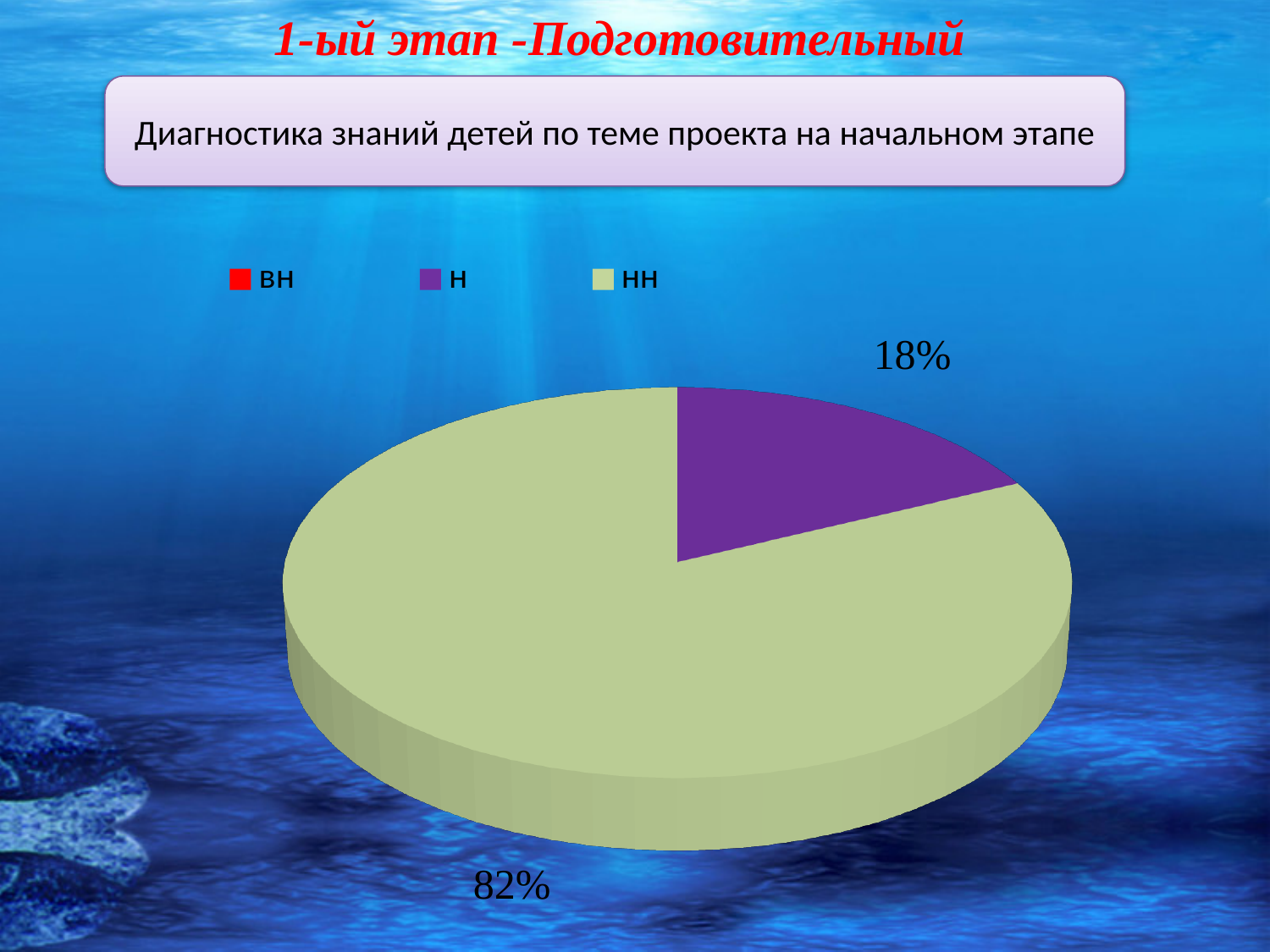
Which category has the largest slice of the pie? НН What kind of chart is shown on the slide? pie chart Which of the two visible slices is larger, Н or НН? НН What colour is the НН slice in the pie chart? light green What share of the pie does the НН slice take? 82% Which legend entry is shown in purple? Н What is the difference in percentage points between the НН slice and the Н slice? 64 What is the total of the two labelled slices, Н and НН? 100% Is the value for Н greater or less than 50%? less How many entries does the legend list? 3 What share of the pie does the Н slice take? 18% Is the value for НН greater or less than 50%? greater